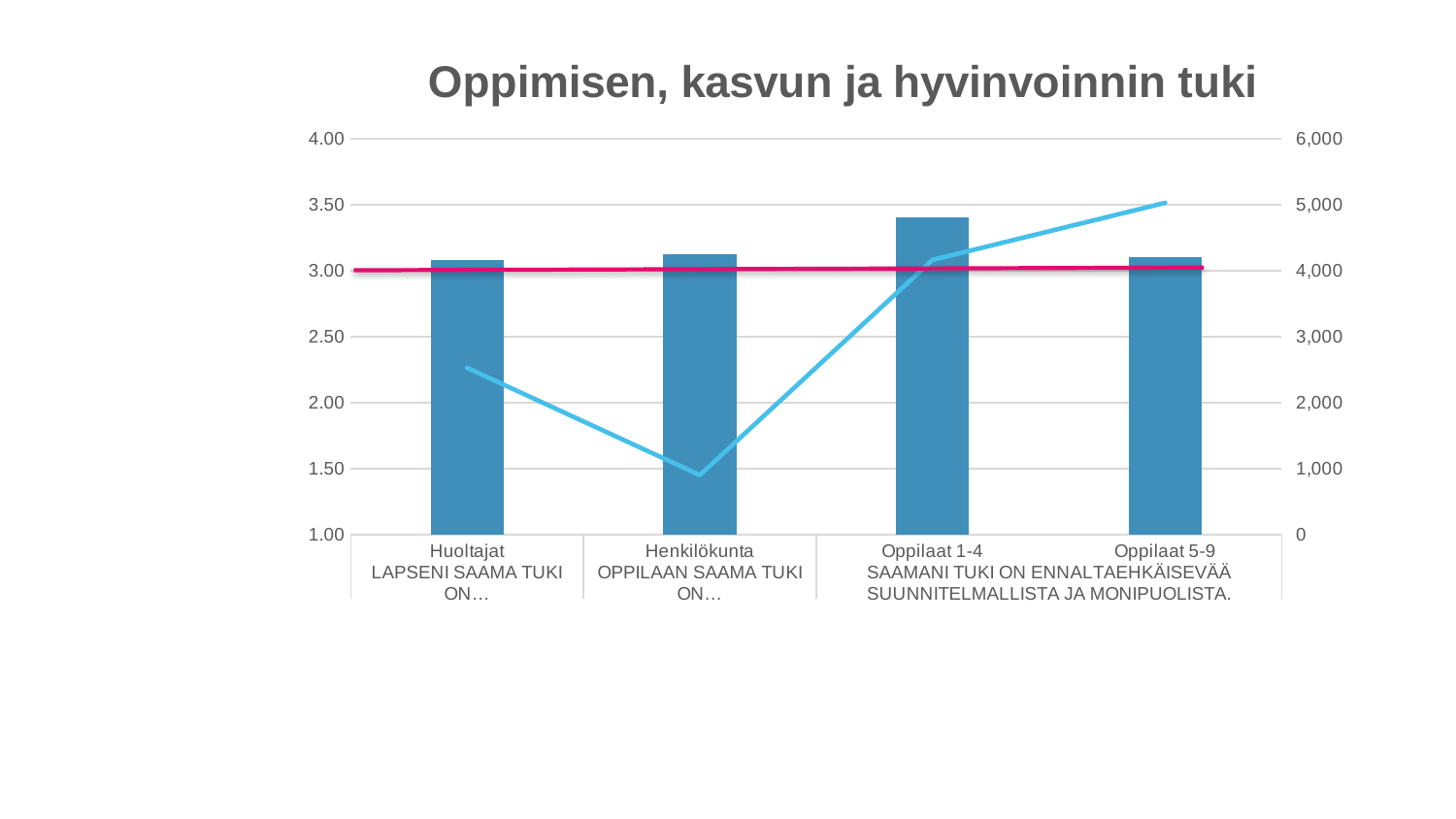
Is the bar value for Huoltajat greater or less than 3.50 on the left axis? less Which category has the lowest point on the light blue line? Henkilökunta How many categories are shown on the x axis of the chart? 4 Is the bar value for Oppilaat 1-4 greater or less than 3.00 on the left axis? greater Is the bar for Oppilaat 1-4 taller or shorter than the bar for Henkilökunta? taller Does the light blue line rise or fall from Henkilökunta to Oppilaat 5-9? rise What is the title of the chart? Oppimisen, kasvun ja hyvinvoinnin tuki Is the light blue line value for Oppilaat 5-9 greater or less than 4,000 on the right axis? greater Which category has the tallest bar? Oppilaat 1-4 What kind of chart is shown on the slide? A combined bar and line chart Which category has the highest point on the light blue line? Oppilaat 5-9